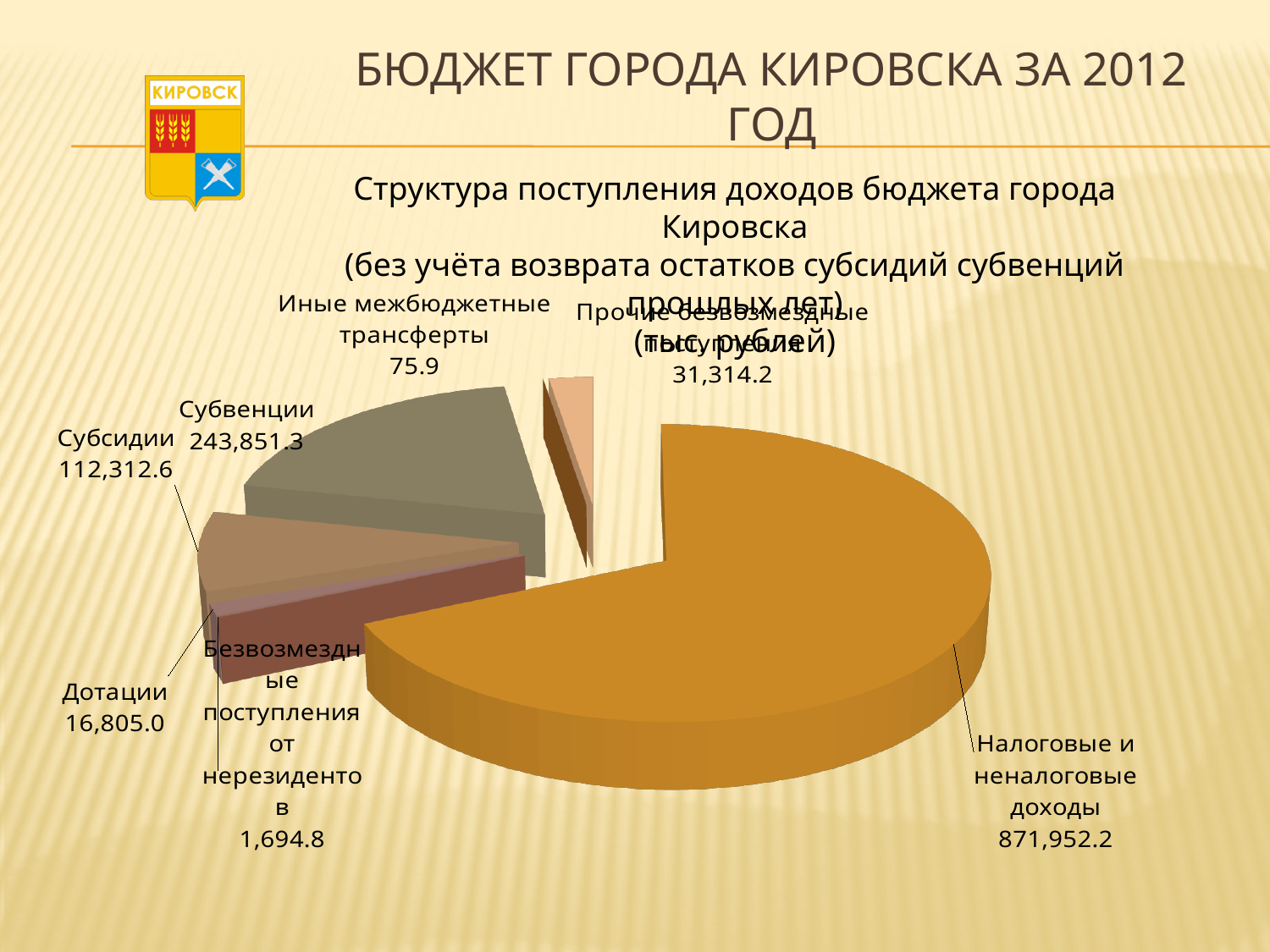
Which category has the smallest value? Иные межбюджетные трансферты What is the difference between Дотации and Безвозмездные поступления от нерезидентов? 15,110.2 Which category has the largest value? Налоговые и неналоговые доходы Which is larger, Прочие безвозмездные поступления or Дотации? Прочие безвозмездные поступления What is the difference between Субвенции and Субсидии? 131,538.7 How many categories does the pie chart show? 7 What is the value for Налоговые и неналоговые доходы? 871,952.2 What kind of chart is shown on the slide? Pie chart What is the value for Иные межбюджетные трансферты? 75.9 What is the value for Дотации? 16,805.0 In what units are the values on the chart given, according to the chart title? тыс. рублей What is the value for Субвенции? 243,851.3